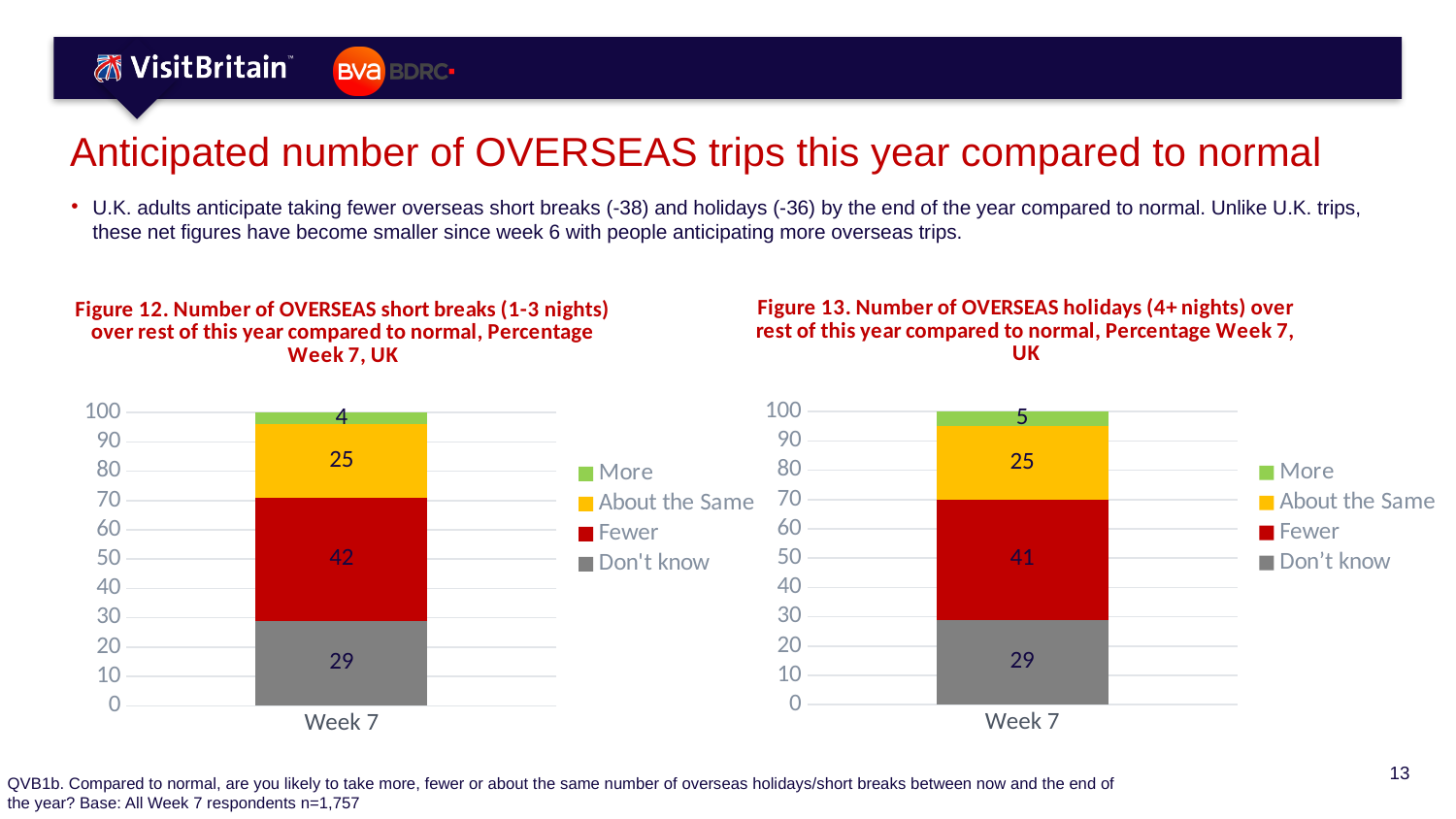
What type of chart is Figure 13 (OVERSEAS holidays)? Stacked bar chart How many series does the legend list in Figure 12 (OVERSEAS short breaks)? 4 In Figure 13 (OVERSEAS holidays), what is the total of the stacked bar for Week 7? 100 In Figure 13 (OVERSEAS holidays), what is the value for 'Fewer' in Week 7? 41 In Figure 12 (OVERSEAS short breaks), what is the difference between the 'Fewer' and 'About the Same' values? 17 In Figure 13 (OVERSEAS holidays), which response category has the smallest value? More In Figure 13 (OVERSEAS holidays), what is the value for 'Don't know'? 29 In Figure 12 (OVERSEAS short breaks), what is the value for 'Fewer' in Week 7? 42 In Figure 12 (OVERSEAS short breaks), which response category has the largest value? Fewer In Figure 12 (OVERSEAS short breaks), what colour represents 'About the Same'? Yellow In Figure 12 (OVERSEAS short breaks), what is the value for 'More'? 4 Is the 'Fewer' value larger in Figure 12 (short breaks) or Figure 13 (holidays)? Figure 12 (short breaks)